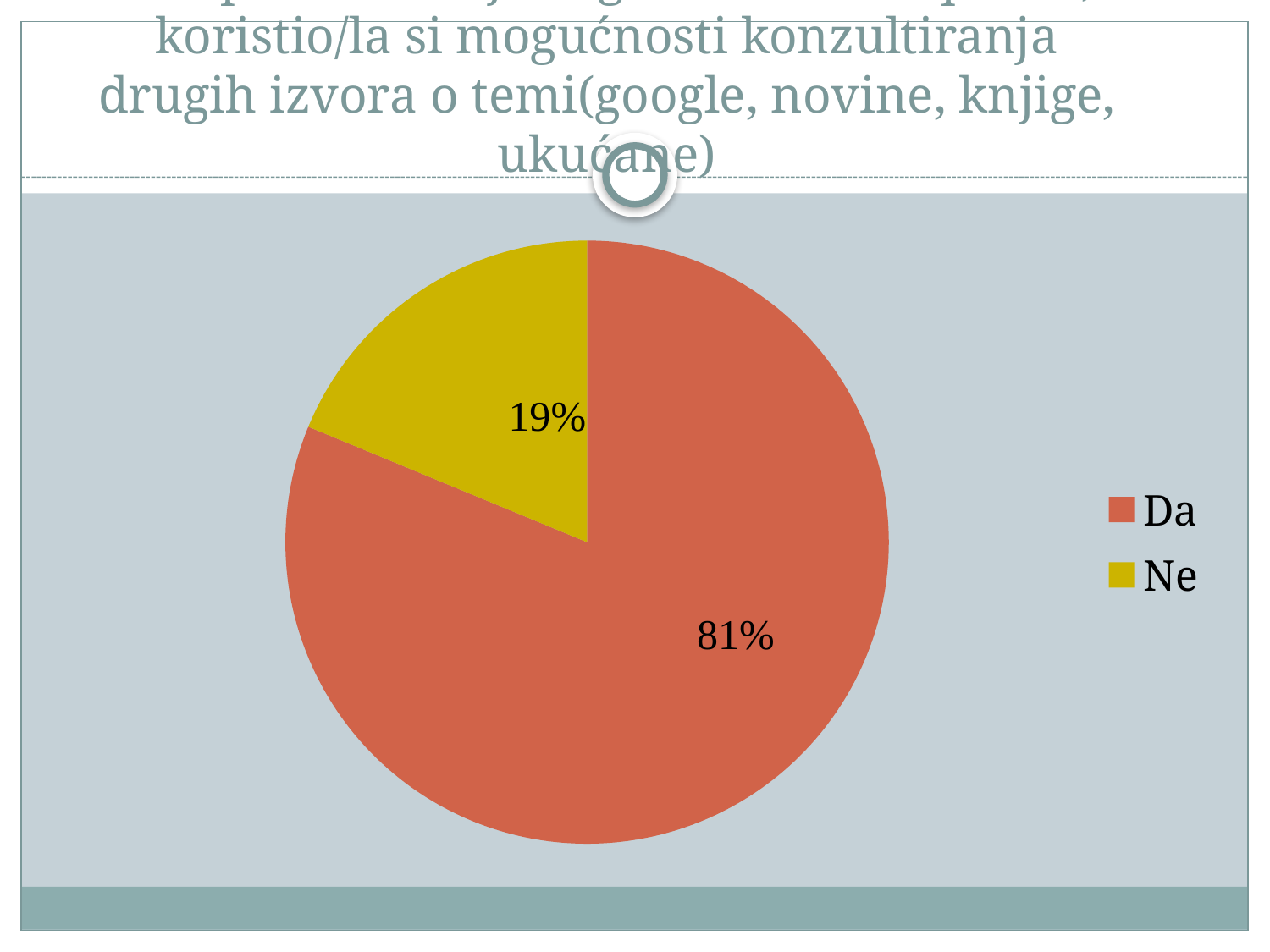
What percentage of the pie chart is labelled "Ne"? 19% What colour is the "Da" slice in the pie chart? Red/orange How many categories does the pie chart show? 2 Which category has the smallest share of the pie chart? Ne What is the difference in percentage points between the "Da" and "Ne" slices? 62 Which slice is larger, "Da" or "Ne"? Da What colour is the "Ne" slice in the pie chart? Yellow What percentage of the pie chart is labelled "Da"? 81% How many entries does the legend list? 2 What share of the pie does the "Ne" slice represent? 19% Which category has the largest share of the pie chart? Da What kind of chart is shown on the slide? Pie chart